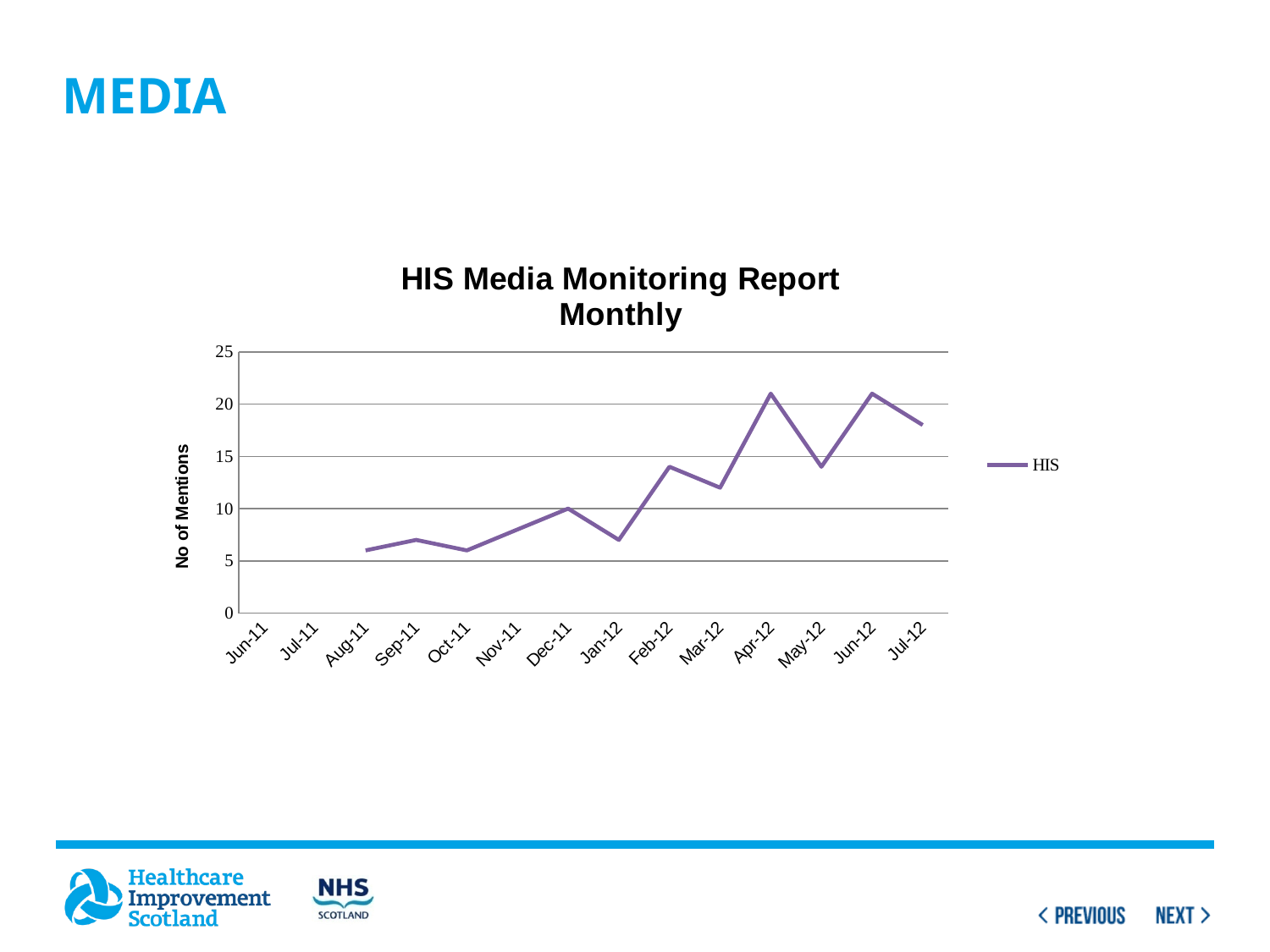
How many series does the legend list? 1 Is the value for Aug-11 greater or less than 10? less Is the value for Apr-12 greater or less than 20? greater What is the number of mentions for Dec-11? 10 What kind of chart is shown on the slide? line chart How many month labels are shown on the x axis? 14 Is the value for Jul-12 greater or less than 15? greater What is the label of the y axis? No of Mentions What is the title of the chart? HIS Media Monitoring Report Monthly Overall, do the number of mentions rise or fall from Aug-11 to Jul-12? rise Which has more mentions, Mar-12 or Apr-12? Apr-12